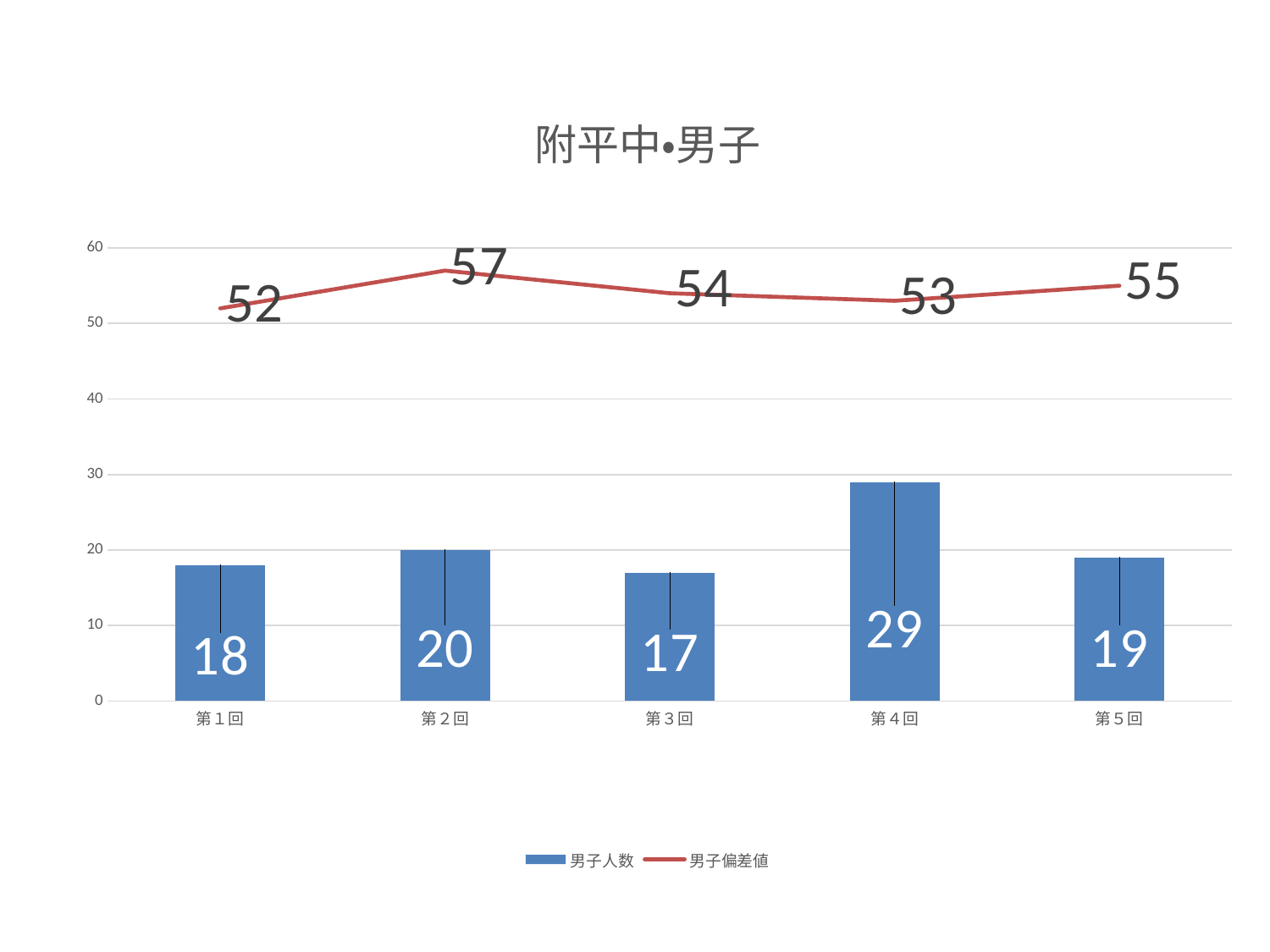
How many series does the legend list? 2 What is the difference in 男子人数 between 第４回 and 第３回? 12 How many rounds are shown on the x axis? 5 What is the 男子人数 value for 第４回? 29 What is the title of the chart? 附平中•男子 Which round has the lowest 男子偏差値? 第１回 What kind of chart is this? Combined bar and line chart What is the 男子偏差値 value for 第２回? 57 Which round has the highest 男子人数? 第４回 Does the 男子偏差値 line rise or fall from 第２回 to 第４回? Fall Which is larger, the 男子偏差値 for 第３回 or for 第５回? 第５回 What is the 男子人数 value for 第３回? 17